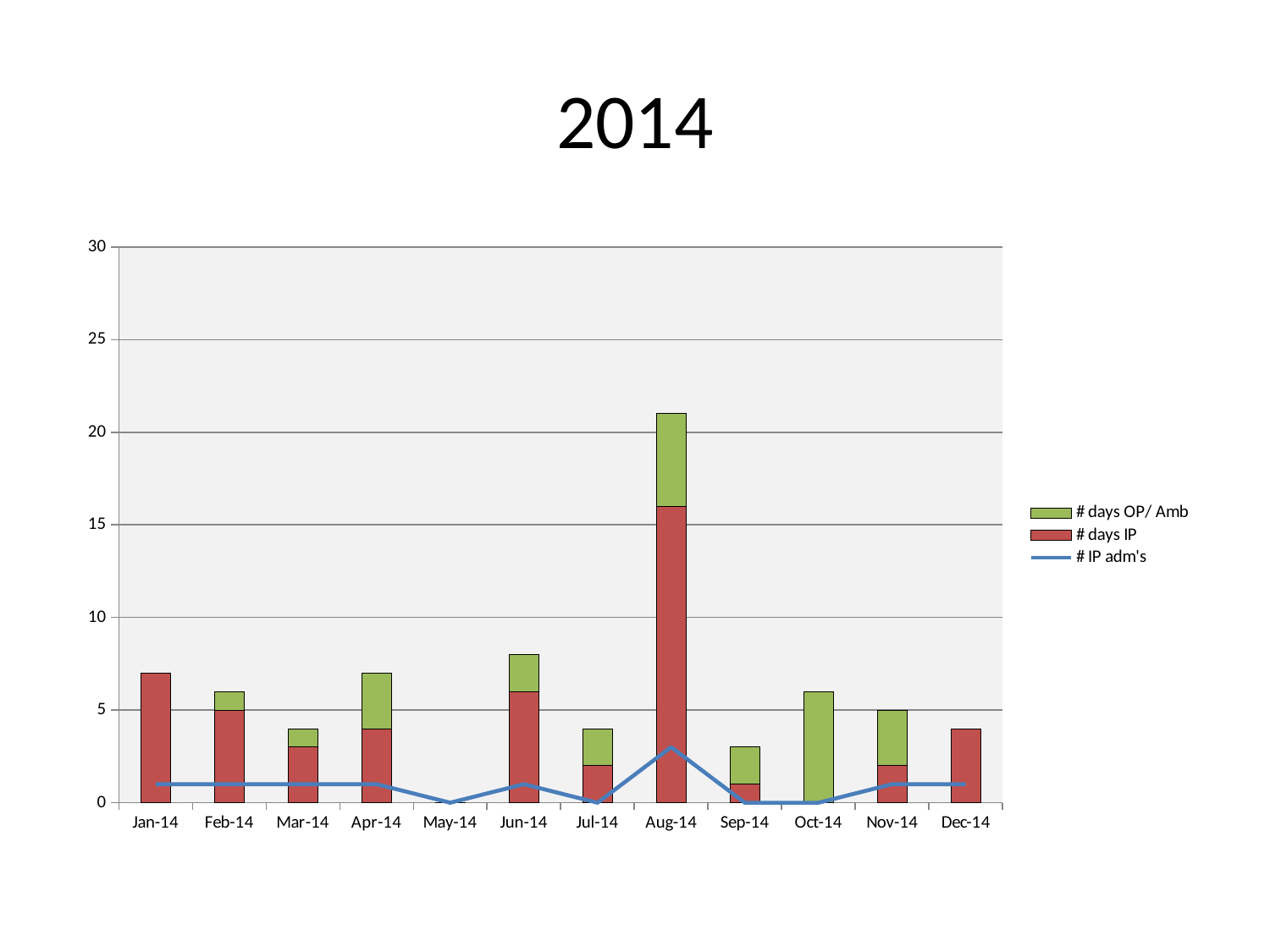
Which series is drawn as a line rather than bars? # IP adm's What kind of chart is shown on the slide? A combined bar and line chart Is the total stacked bar for Jan-14 greater or less than 5? greater Is the total stacked bar for Aug-14 greater or less than 20? greater Is the total stacked bar for Mar-14 greater or less than 5? less Which month has no bar at all? May-14 Which month has the tallest stacked bar? Aug-14 How many series does the legend list? 3 Which is larger, the total stacked bar for Jun-14 or for Jul-14? Jun-14 How many months are shown along the x axis? 12 What is the title of the slide? 2014